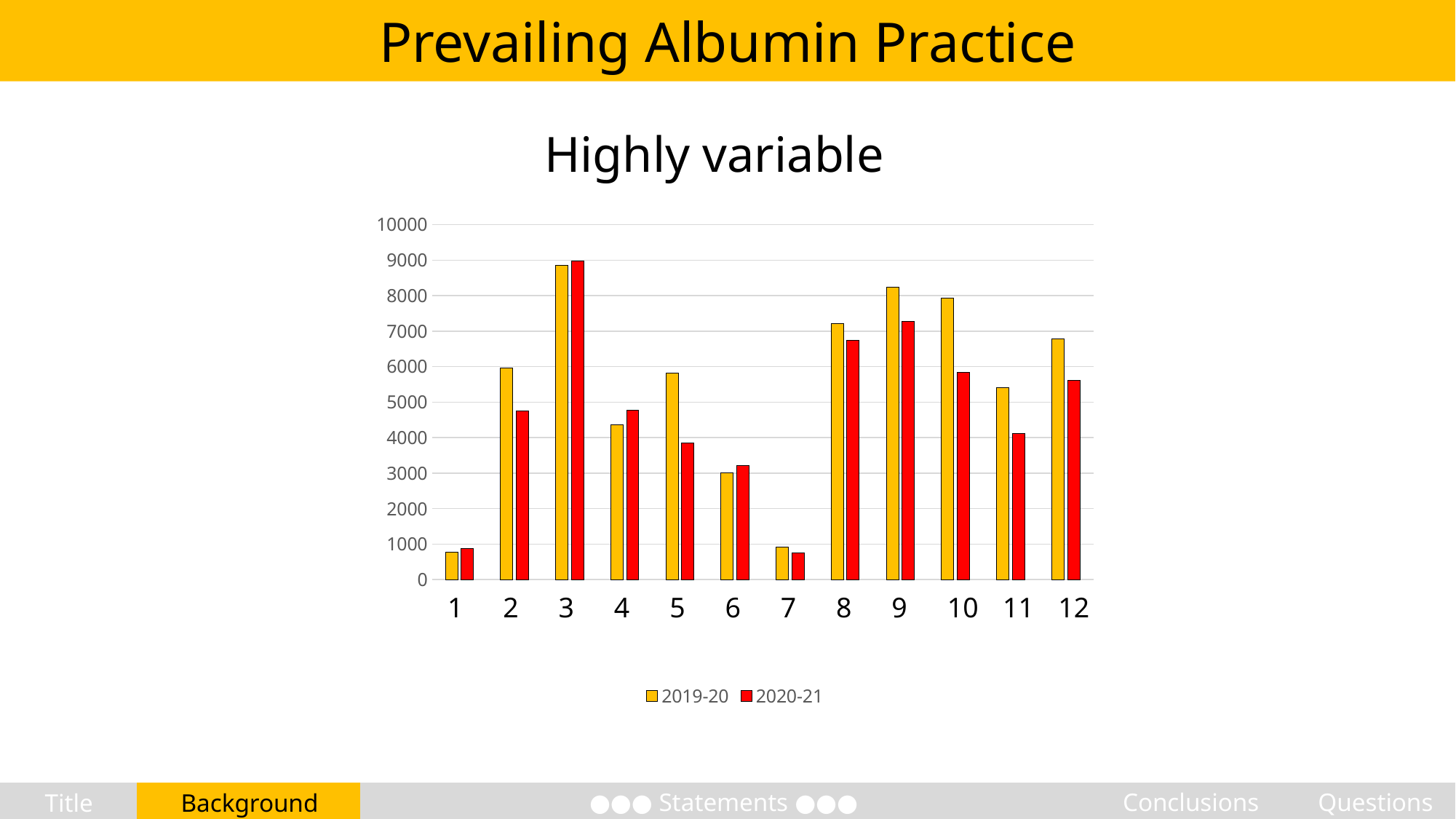
Which category has the highest value for the 2020-21 series? 3 How many categories are shown on the x axis of the chart? 12 Is the 2020-21 value for category 8 greater or less than 6000? greater Which series is shown in red in the chart? 2020-21 What is the title of the chart? Highly variable Is the 2019-20 value for category 10 greater or less than 7000? greater For category 4, which series has the larger value, 2019-20 or 2020-21? 2020-21 How many series does the chart's legend list? 2 What kind of chart is shown on the slide? bar chart Which category has the highest value for the 2019-20 series? 3 For category 5, which series has the larger value, 2019-20 or 2020-21? 2019-20 Is the 2019-20 value for category 6 greater or less than 4000? less